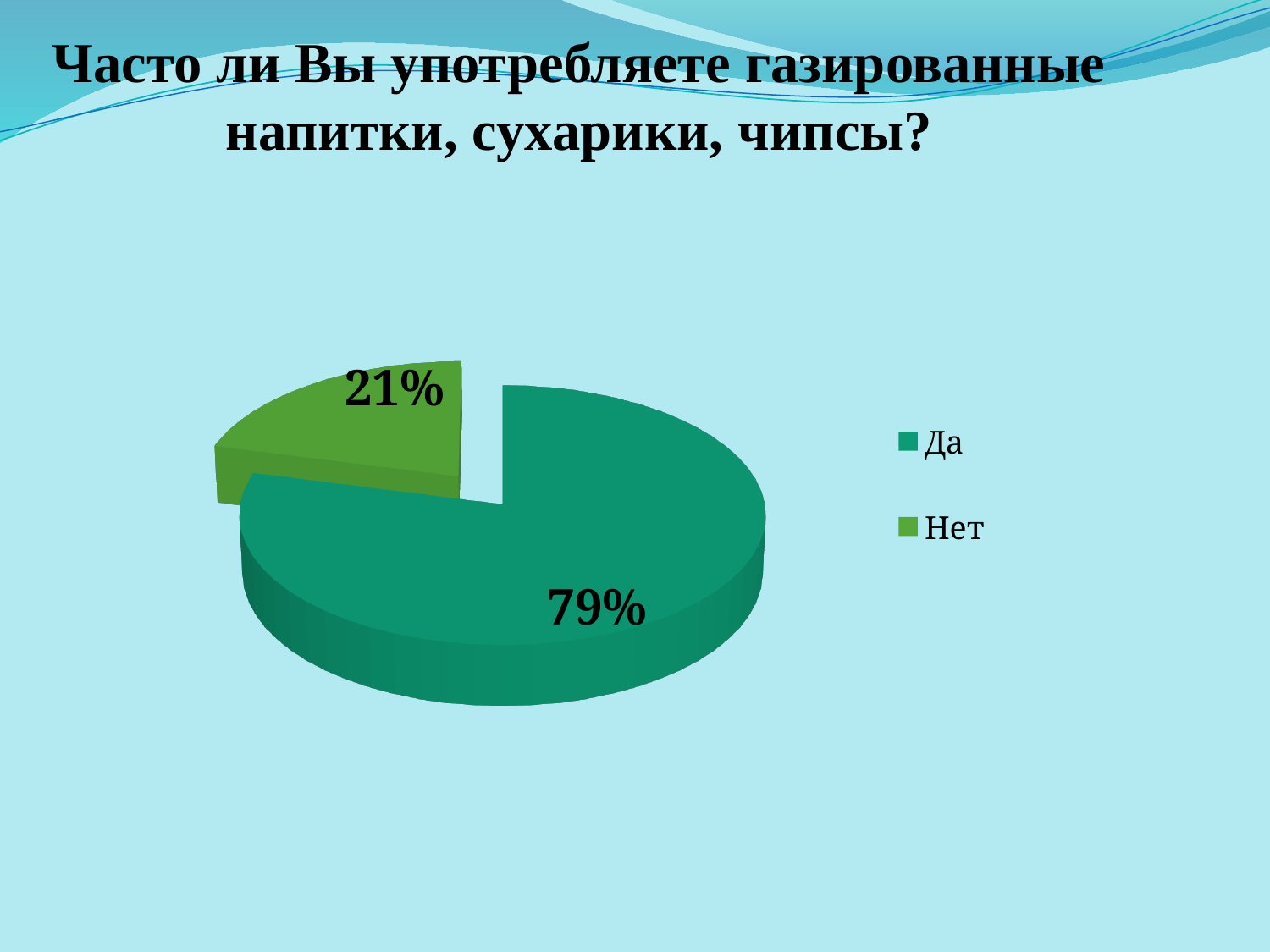
What share of the pie does the "Да" slice represent? 79% What kind of chart is shown on the slide? Pie chart Which category has the smallest slice of the pie? Нет Which legend entry is shown in light green? Нет How many slices does the pie chart have? 2 What is the title of the slide above the chart? Часто ли Вы употребляете газированные напитки, сухарики, чипсы? How many entries does the legend list? 2 What is the difference in percentage points between the "Да" and "Нет" slices? 58 Which category has the largest slice of the pie? Да Which slice is larger, "Да" or "Нет"? Да What share of the pie does the "Нет" slice represent? 21%